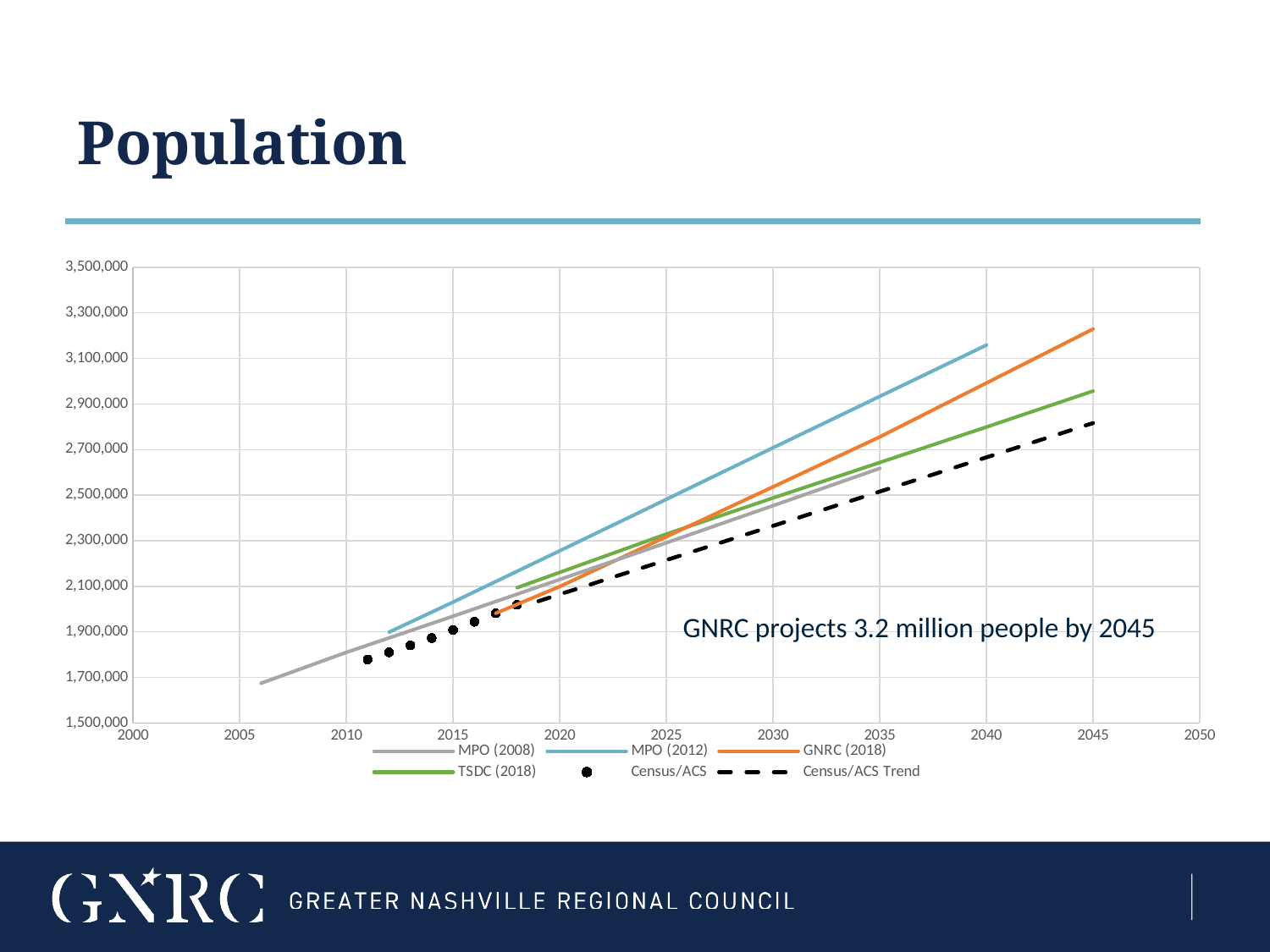
What is the title of the slide containing the chart? Population Is the value of the TSDC (2018) line at 2045 greater or less than 3,100,000? less What kind of chart is shown on the slide? Line chart How many series does the legend list? 6 At 2040, which line is higher: MPO (2012) or GNRC (2018)? MPO (2012) At 2045, which line is higher: GNRC (2018) or TSDC (2018)? GNRC (2018) Is the value of the GNRC (2018) line at 2045 greater or less than 3,100,000? greater Do the projection lines rise or fall as the years increase along the x axis? Rise Which series reaches the highest population value on the chart? GNRC (2018) Is the value of the MPO (2008) line at 2035 greater or less than 2,500,000? greater According to the annotation on the chart, how many people does GNRC project by 2045? 3.2 million